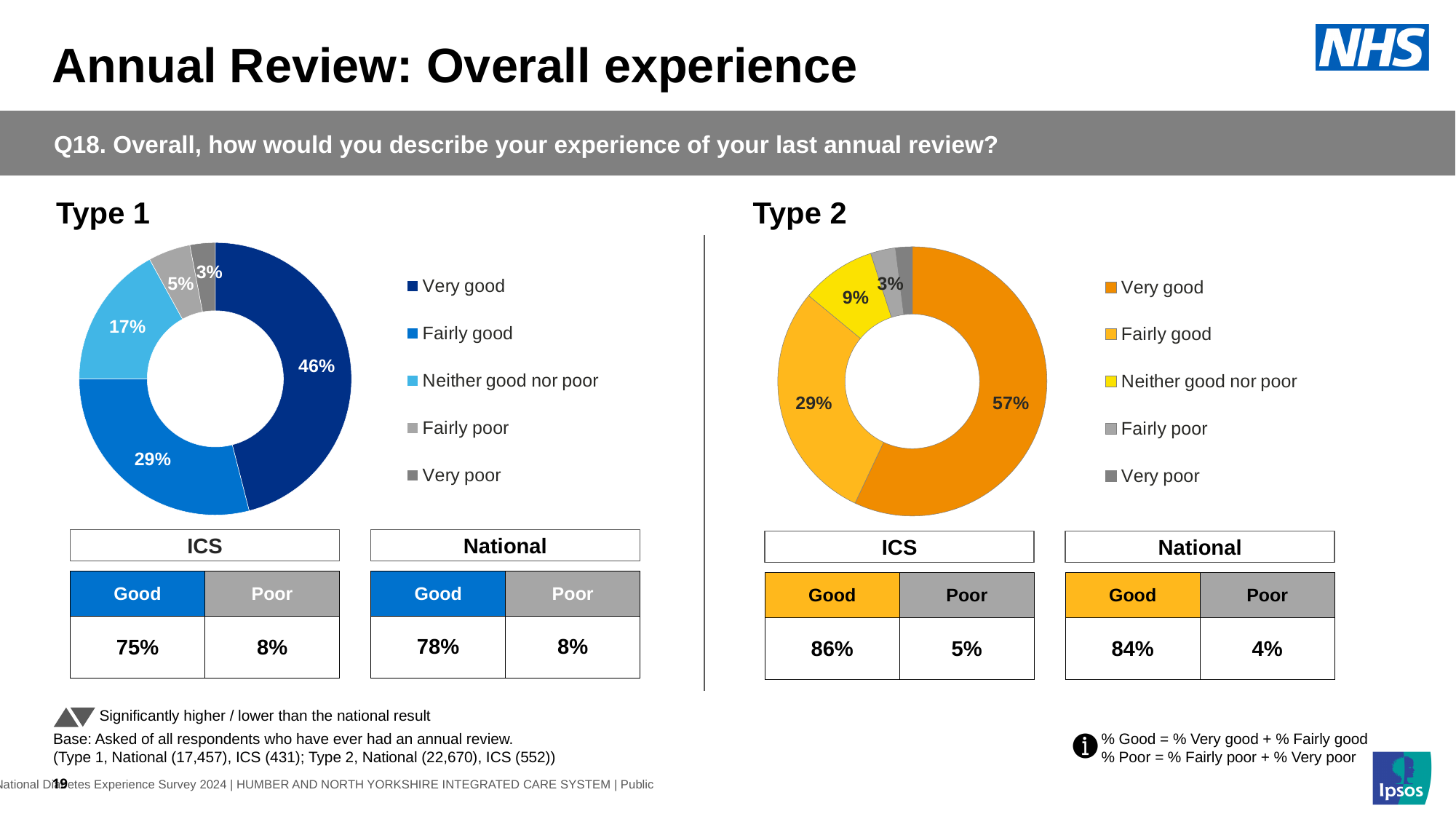
In the Type 1 chart, what percentage of respondents said Fairly poor? 5% How many categories does the legend of the Type 1 chart list? 5 Which chart has the larger Very good share, Type 1 or Type 2? Type 2 In the Type 1 chart, what percentage of respondents said Neither good nor poor? 17% In the Type 2 chart, what percentage of respondents said Neither good nor poor? 9% In the Type 2 chart, what is the difference between the Very good and Fairly good shares? 28 percentage points In the Type 1 chart, what percentage of respondents said their experience was Very good? 46% In the Type 1 chart, what is the difference between the Very good and Fairly good shares? 17 percentage points In the Type 1 chart, which category has the smallest share? Very poor In the Type 1 chart, which category has the largest share? Very good In the Type 2 chart, what percentage of respondents said their experience was Very good? 57% What kind of chart is used for Type 1? Donut (pie) chart